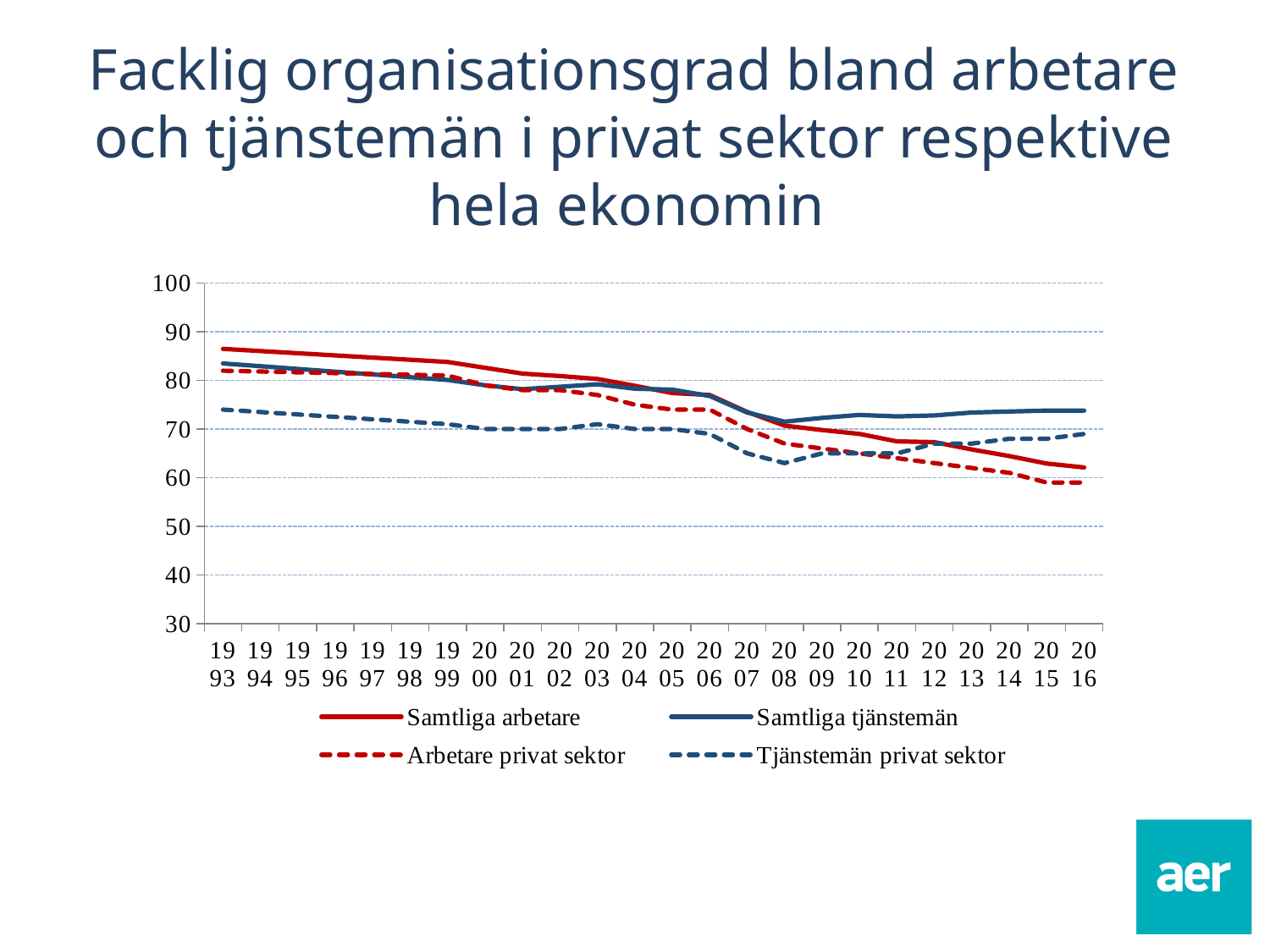
Which series has the lowest value in 2016? Arbetare privat sektor How many years are shown on the x axis? 24 Is the value for Samtliga arbetare in 1993 greater or less than 80? greater Does the value for Samtliga arbetare rise or fall from 1993 to 2016? fall Which series has the highest value in 1993? Samtliga arbetare Is the value for Samtliga tjänstemän in 2016 greater or less than 70? greater Which series is drawn as a dashed red line? Arbetare privat sektor Is the value for Tjänstemän privat sektor in 2008 greater or less than 70? less How many series does the legend list? 4 In 2016, which is larger: Samtliga tjänstemän or Samtliga arbetare? Samtliga tjänstemän What kind of chart is shown on the slide? line chart